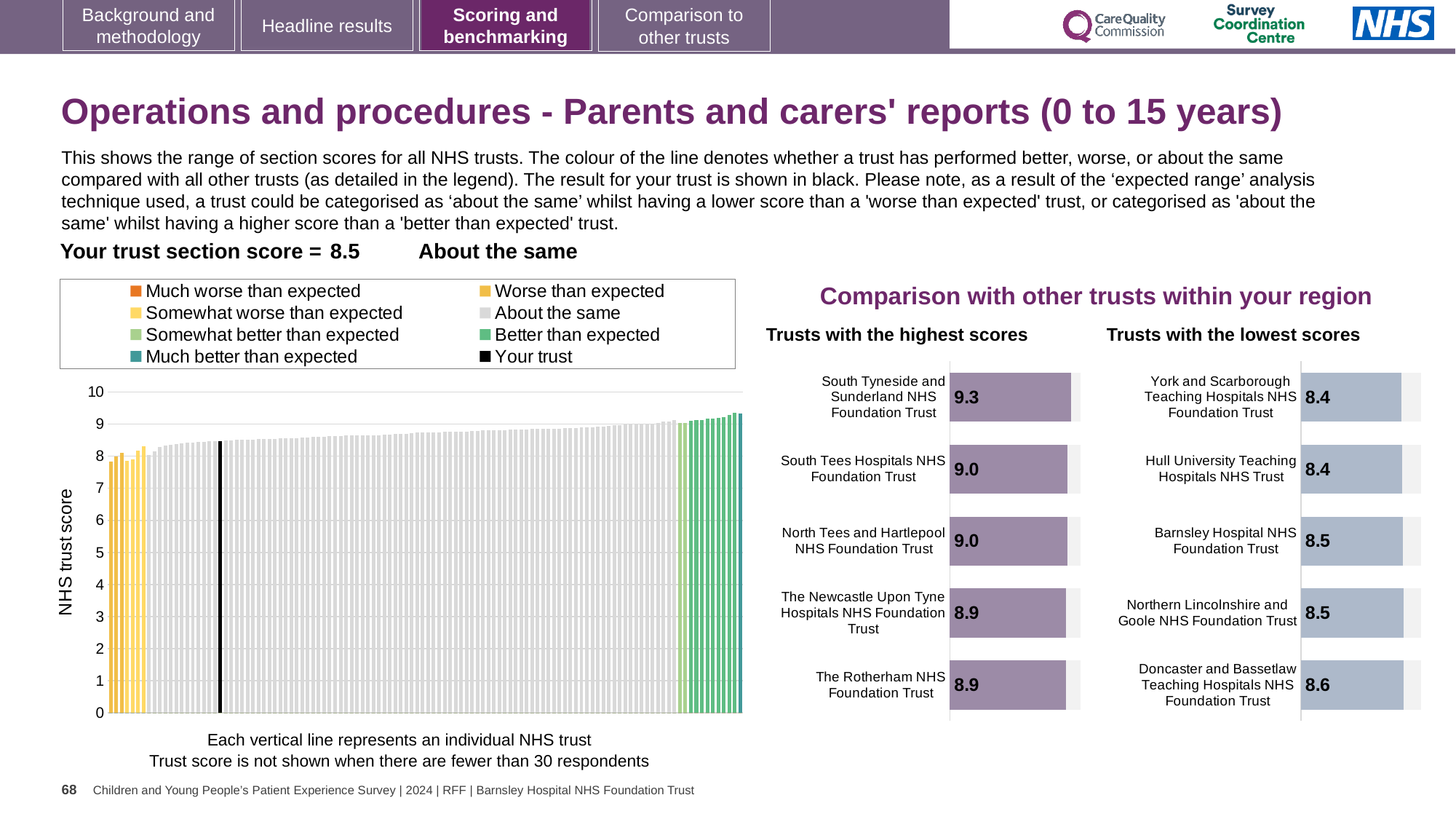
In the 'Trusts with the lowest scores' chart, which trust has the highest score? Doncaster and Bassetlaw Teaching Hospitals NHS Foundation Trust How many entries does the legend above the large chart on the left list? 8 In the large chart on the left, is the value for the black bar (your trust) greater or less than 8? greater In the 'Trusts with the highest scores' chart, what is the score for South Tyneside and Sunderland NHS Foundation Trust? 9.3 In the 'Trusts with the highest scores' chart, how many trusts are shown? 5 In the 'Trusts with the lowest scores' chart, what is the score for Doncaster and Bassetlaw Teaching Hospitals NHS Foundation Trust? 8.6 In the 'Trusts with the highest scores' chart, what is the difference between the scores of South Tyneside and Sunderland NHS Foundation Trust and The Rotherham NHS Foundation Trust? 0.4 What kind of chart is the large chart on the left showing NHS trust scores? bar chart In the large chart on the left, is the value for the tallest green bar greater or less than 9? greater In the large chart on the left, what is the label on the vertical axis? NHS trust score In the 'Trusts with the lowest scores' chart, which is larger: the score for Barnsley Hospital NHS Foundation Trust or the score for Hull University Teaching Hospitals NHS Trust? Barnsley Hospital NHS Foundation Trust In the 'Trusts with the highest scores' chart, which trust has the highest score? South Tyneside and Sunderland NHS Foundation Trust